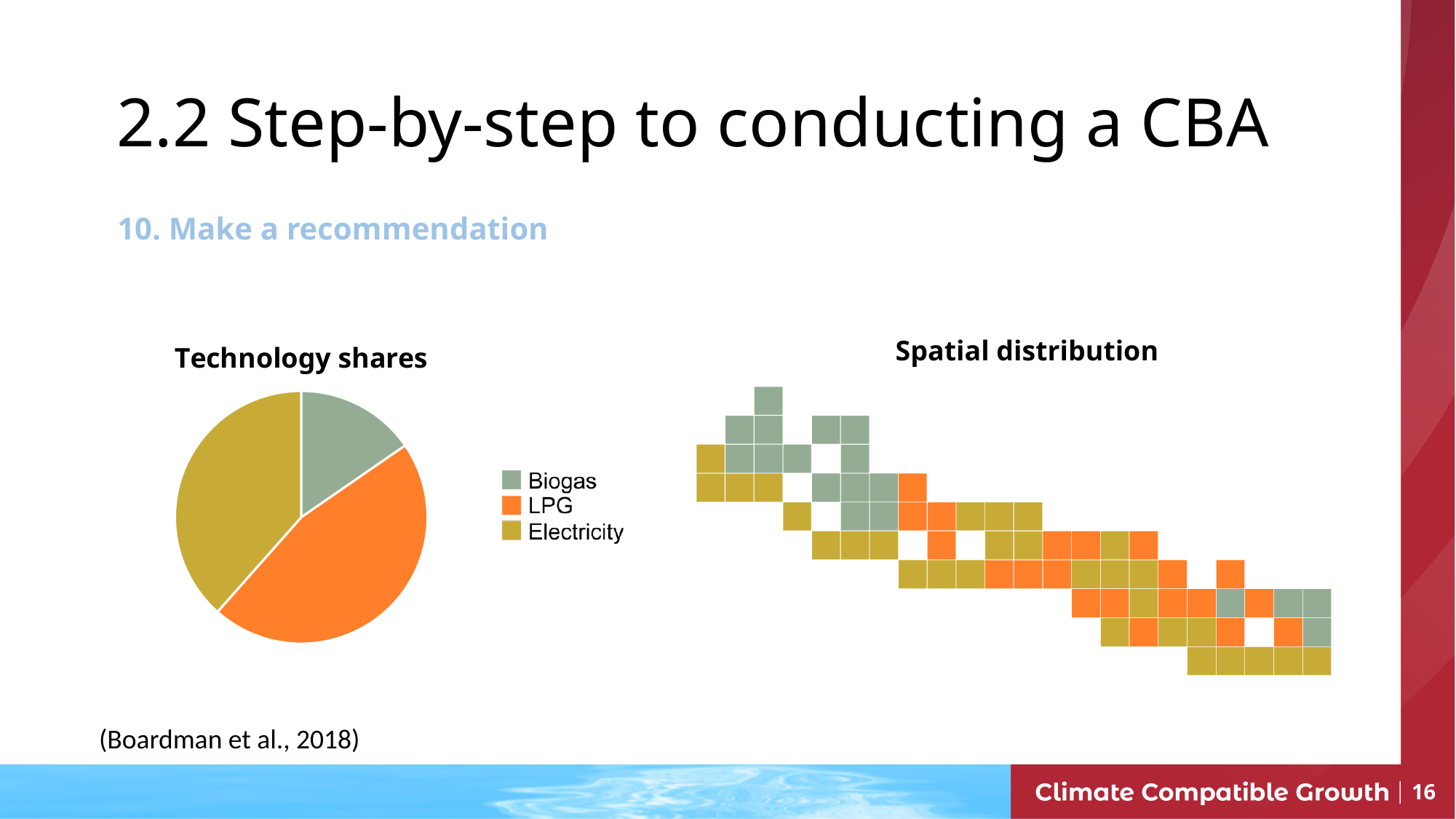
How many entries does the legend of the Technology shares chart list? 3 How many slices does the Technology shares pie chart have? 3 In the Technology shares pie chart, which technology has the smallest share? Biogas What is the title of the grid map on the right of the slide? Spatial distribution What is the title of the pie chart on the left of the slide? Technology shares In the Technology shares chart, which technology is shown in orange? LPG In the Technology shares pie chart, which slice is larger, LPG or Biogas? LPG In the Technology shares pie chart, which slice is larger, Electricity or Biogas? Electricity What kind of chart is the Technology shares chart? pie chart